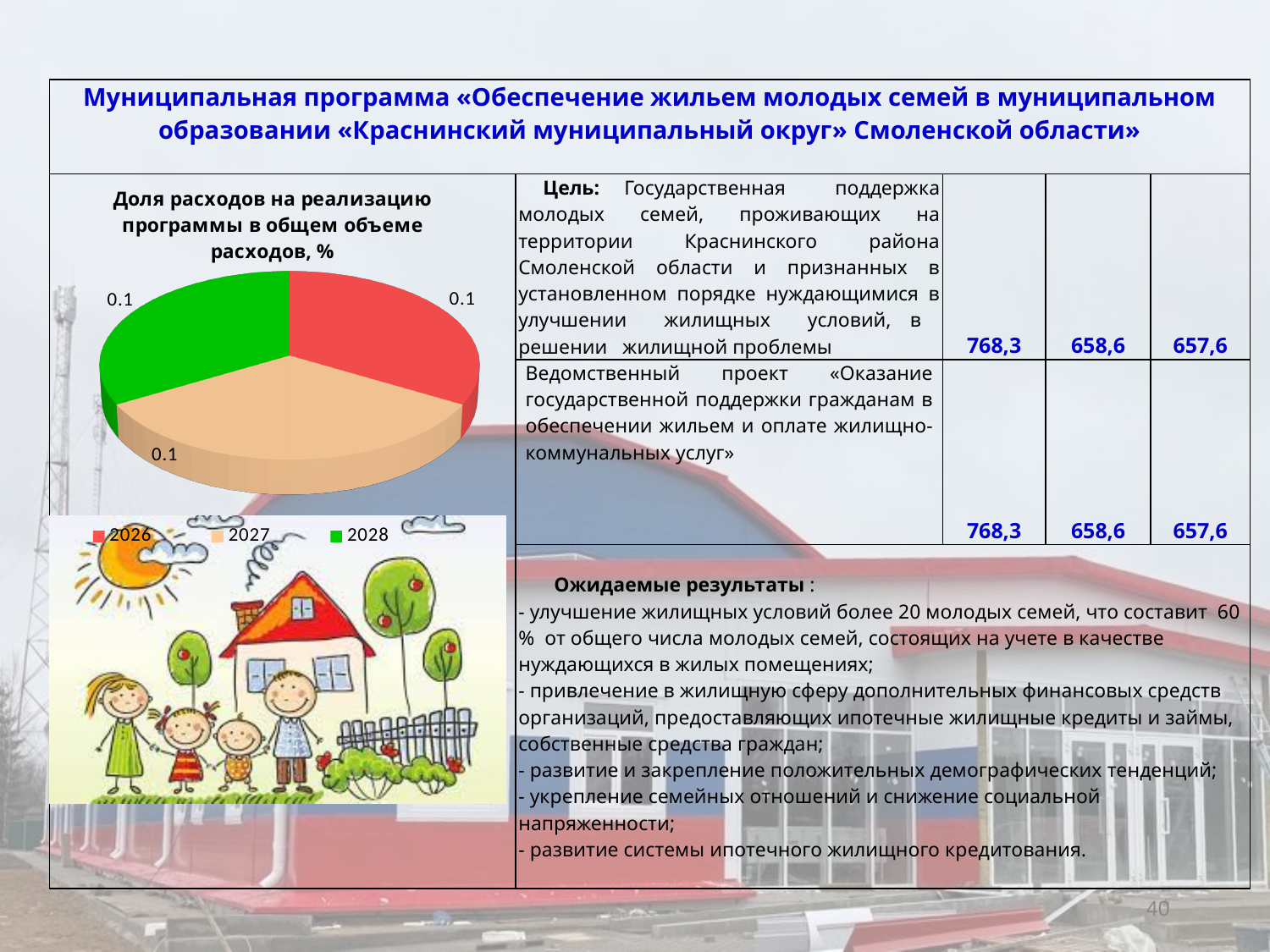
How many entries does the legend of the pie chart list? 3 What value is labelled on the slice for 2028 in the pie chart? 0.1 How many slices does the pie chart have? 3 What kind of chart is shown on the slide? pie chart What is the title of the pie chart? Доля расходов на реализацию программы в общем объеме расходов, % Is the value labelled for 2027 in the pie chart greater or less than 1? less What is the difference between the values labelled for 2026 and 2028 in the pie chart? 0 What value is labelled on the slice for 2026 in the pie chart? 0.1 What value is labelled on the slice for 2027 in the pie chart? 0.1 Which years are listed in the legend of the pie chart? 2026, 2027, 2028